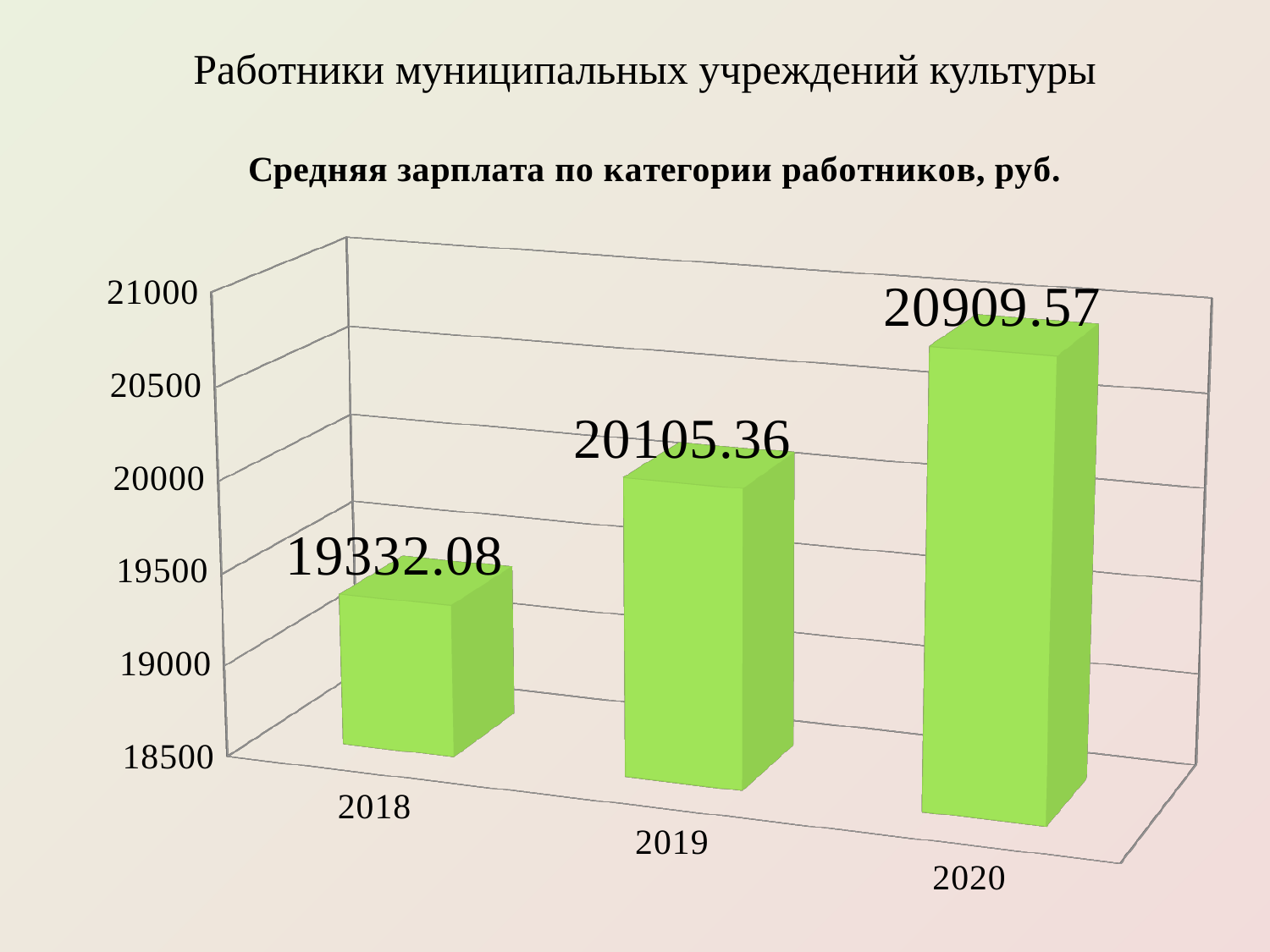
What is the difference between the 2020 and 2019 values? 804.21 What is the average salary value shown for 2019? 20105.36 Which year has the highest average salary? 2020 Which is larger, the value for 2019 or the value for 2018? 2019 How many years are shown on the chart? 3 Which year has the lowest average salary? 2018 What kind of chart is shown on the slide? bar chart What is the difference between the 2019 and 2018 values? 773.28 Is the value for 2020 greater or less than 20500? greater What is the average salary value shown for 2020? 20909.57 What is the average salary value shown for 2018? 19332.08 Do the values rise or fall from 2018 to 2020? rise